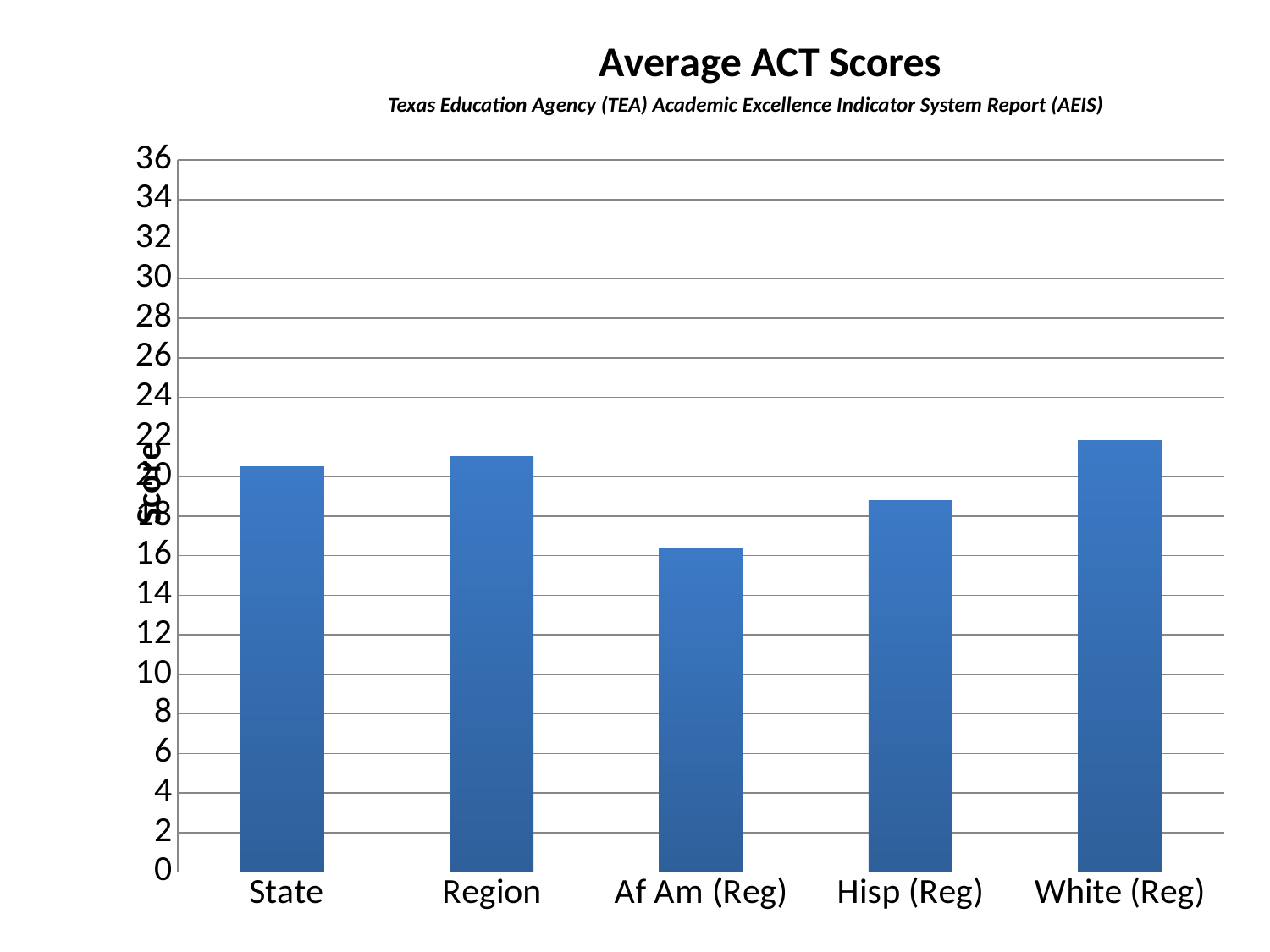
Which is larger, the value for Hisp (Reg) or the value for Af Am (Reg)? Hisp (Reg) Is the value for White (Reg) greater or less than 20? greater Is the value for Region greater or less than 20? greater How many categories are shown on the x axis? 5 Which is larger, the value for State or the value for Hisp (Reg)? State Is the value for Hisp (Reg) greater or less than 20? less Which category has the highest average ACT score? White (Reg) Which category has the lowest average ACT score? Af Am (Reg) What kind of chart is shown on the slide? bar chart What is the title of the chart? Average ACT Scores